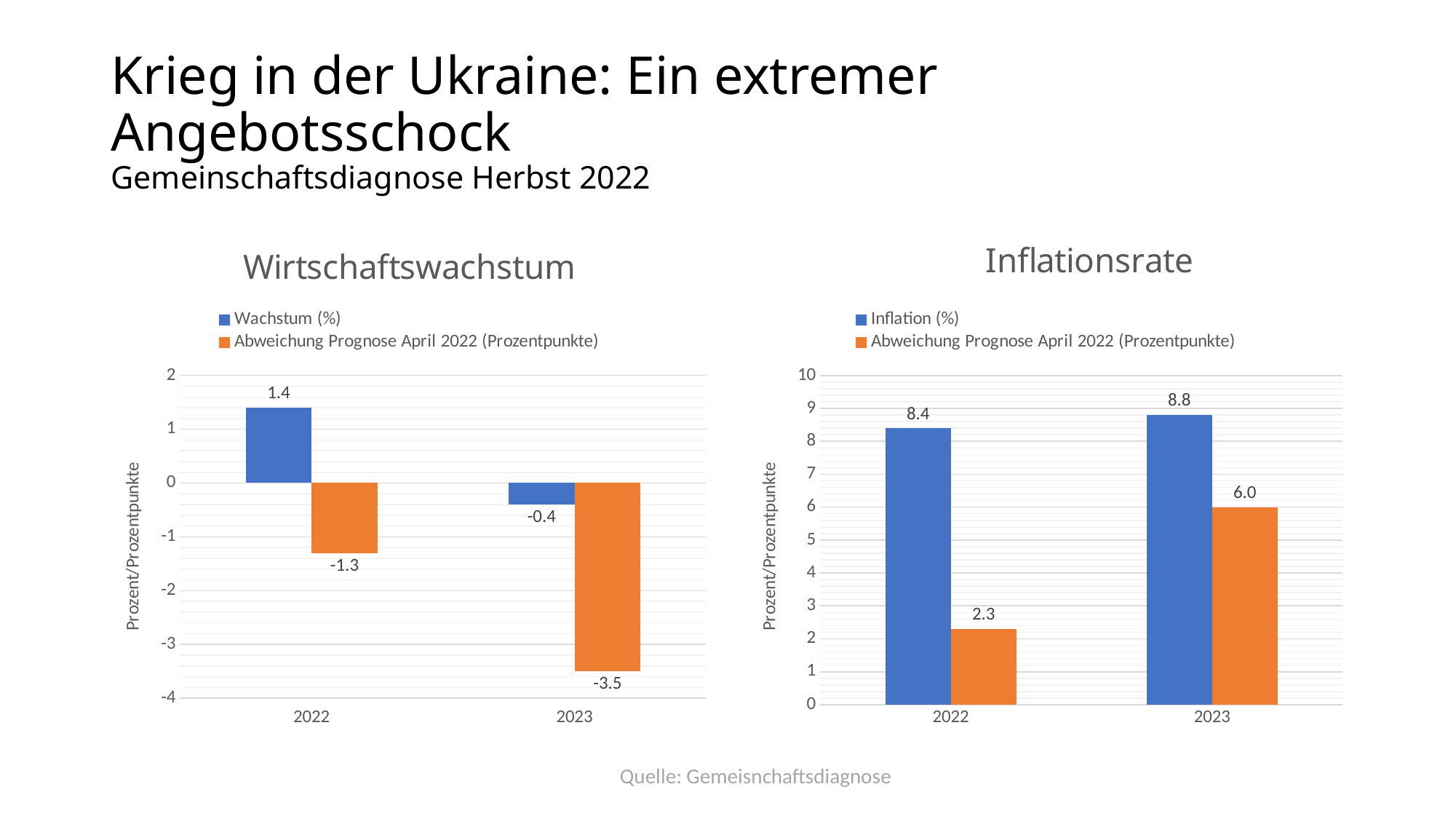
In the Wirtschaftswachstum chart, what is the Abweichung Prognose April 2022 value for 2023? -3.5 In the Inflationsrate chart, what is the difference between the Inflation (%) values for 2023 and 2022? 0.4 What kind of chart is the Wirtschaftswachstum chart? bar chart In the Inflationsrate chart, which year has the higher Inflation (%) value? 2023 In the Inflationsrate chart, what is the Inflation (%) value for 2023? 8.8 In the Wirtschaftswachstum chart, what is the difference between the Wachstum (%) values for 2022 and 2023? 1.8 How many series does the legend of the Inflationsrate chart list? 2 In the Wirtschaftswachstum chart, does the Wachstum (%) value rise or fall from 2022 to 2023? fall In the Wirtschaftswachstum chart, which year has the lower Abweichung Prognose April 2022 value? 2023 In the Inflationsrate chart, what is the Abweichung Prognose April 2022 value for 2022? 2.3 In the Wirtschaftswachstum chart, what is the Wachstum (%) value for 2022? 1.4 In the Inflationsrate chart, is the Abweichung Prognose April 2022 value for 2023 larger or smaller than the Inflation (%) value for 2023? smaller